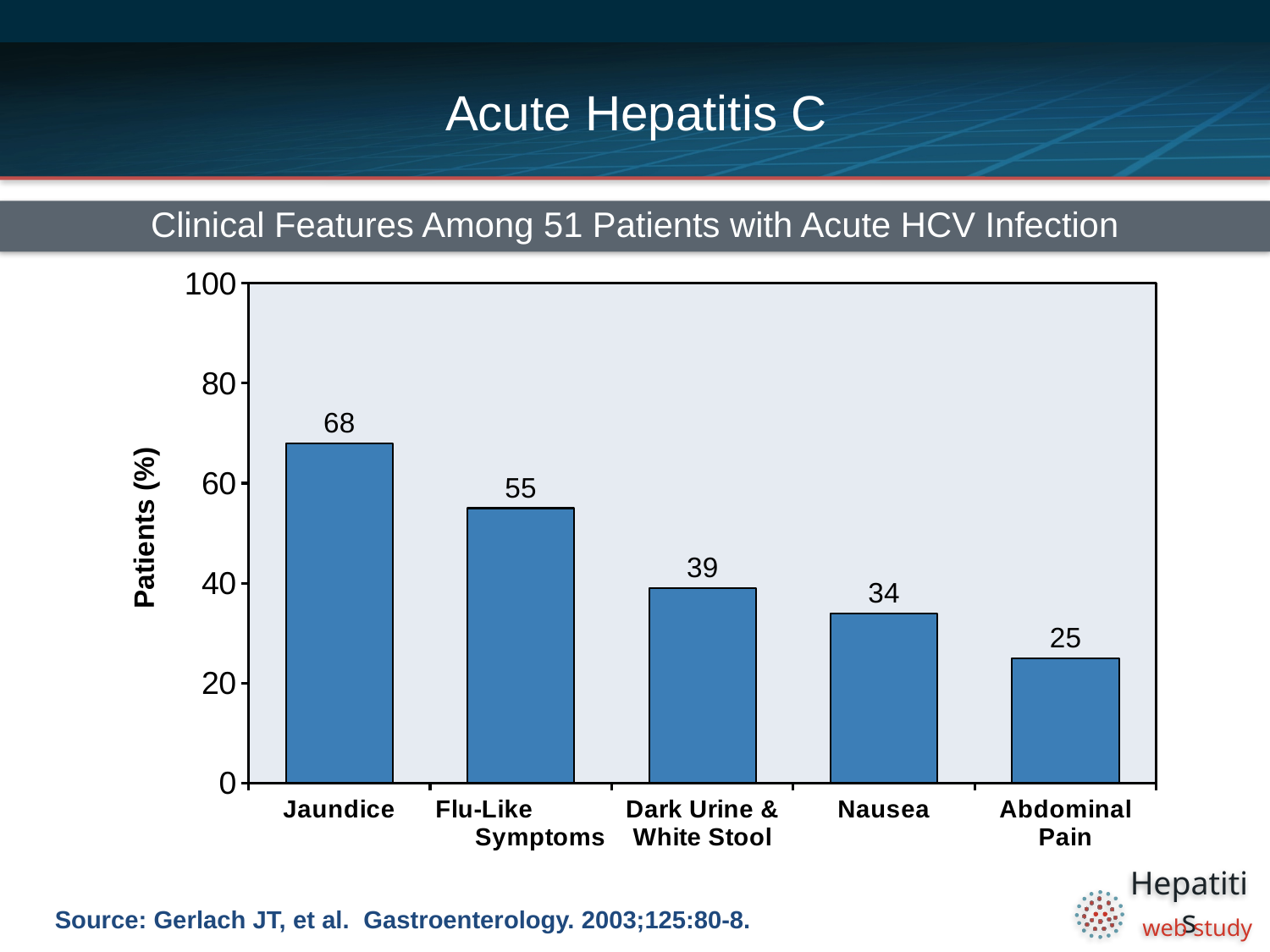
Which clinical feature has the lowest percentage of patients? Abdominal Pain What percentage of patients had Dark Urine & White Stool? 39 What is the difference between the values for Jaundice and Nausea? 34 What is the value for Abdominal Pain? 25 What kind of chart is shown on the slide? Bar chart What is the label of the y axis? Patients (%) Is the value for Nausea greater or less than 40? less What percentage of patients had jaundice? 68 How many clinical features are shown on the chart? 5 What is the value for Flu-Like Symptoms? 55 Which is larger, the value for Flu-Like Symptoms or the value for Dark Urine & White Stool? Flu-Like Symptoms Which clinical feature has the highest percentage of patients? Jaundice